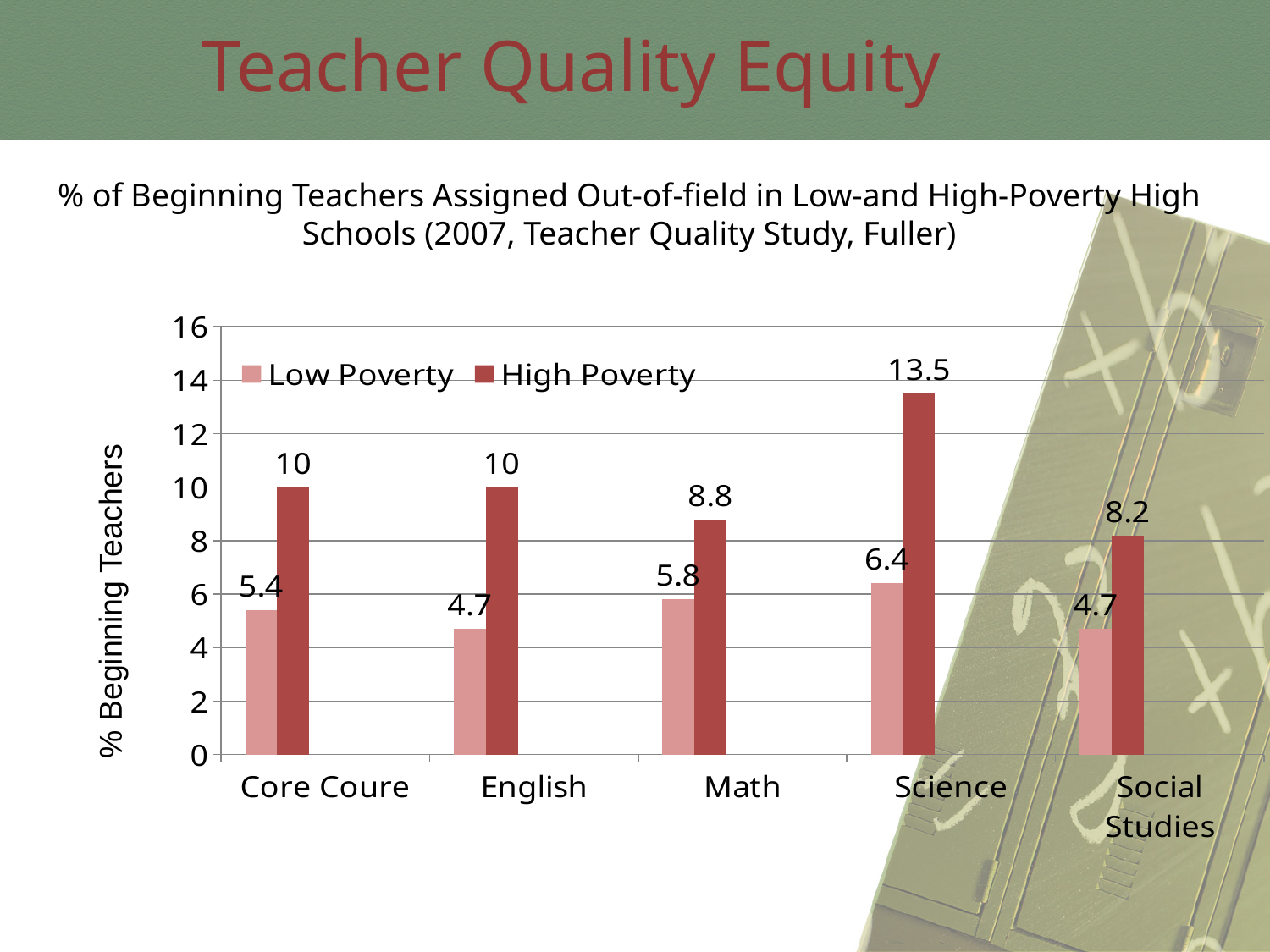
What is the difference between the High Poverty and Low Poverty values for English? 5.3 What is the High Poverty value for Social Studies? 8.2 Which category has the highest High Poverty value? Science What is the High Poverty value for Science? 13.5 Which category has the lowest High Poverty value? Social Studies What is the Low Poverty value for Math? 5.8 What is the Low Poverty value for Core Coure? 5.4 How many series does the legend list? 2 Which is larger, the Low Poverty value for Science or the Low Poverty value for English? Science How many categories are shown on the x axis? 5 What is the difference between the High Poverty and Low Poverty values for Science? 7.1 What kind of chart is shown on the slide? Bar chart